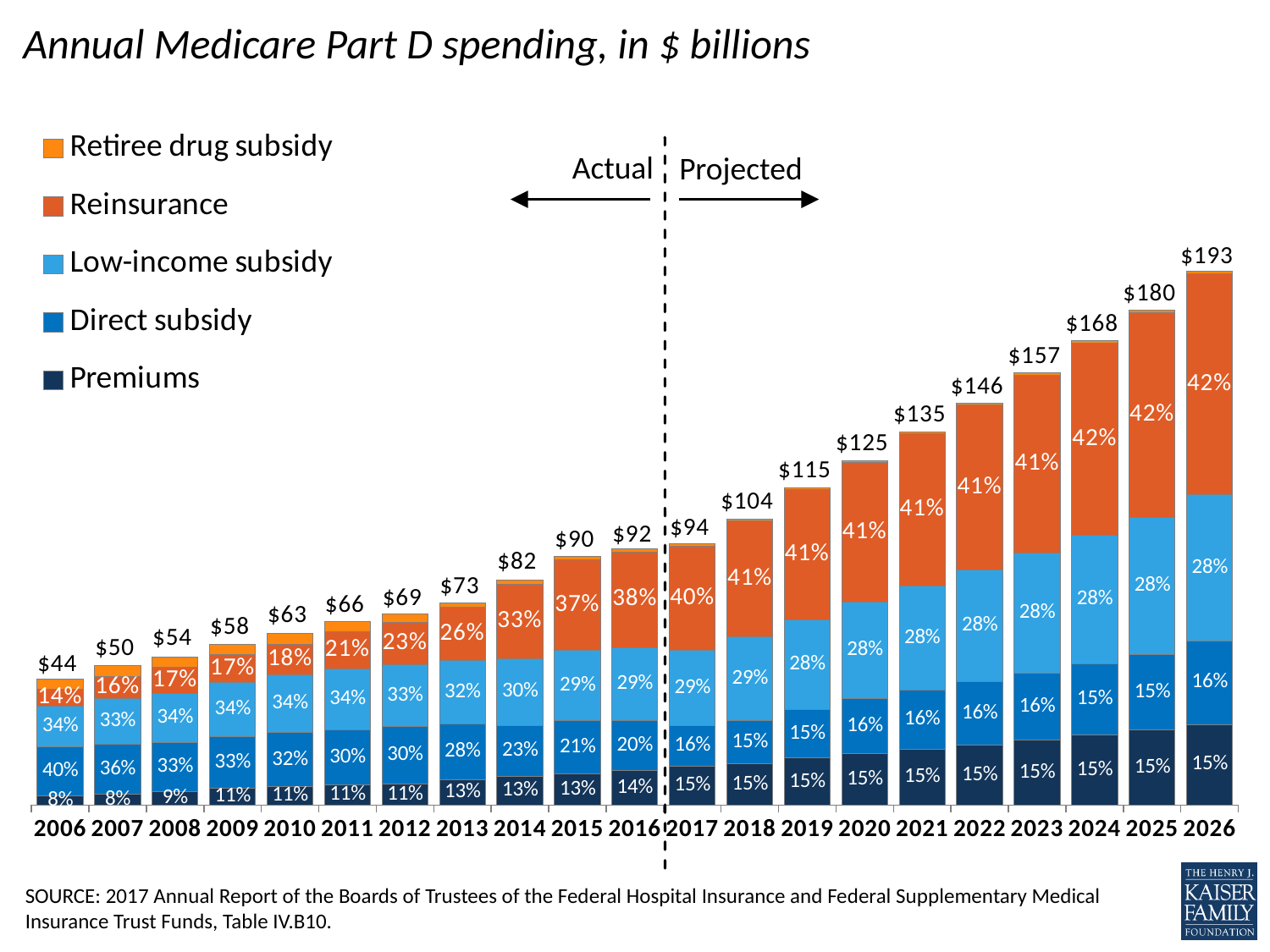
Which year has the lowest total spending? 2006 How many years are shown on the x axis? 21 What kind of chart is this? Stacked bar chart What is the total annual Medicare Part D spending shown for 2006? $44 Do the total spending values rise or fall from 2006 to 2026? Rise Which year has the highest total spending? 2026 What is the total annual Medicare Part D spending shown for 2026? $193 What percentage of 2026 spending is labeled as Reinsurance? 42% What percentage of 2006 spending is labeled as Direct subsidy? 40% What is the difference between the total spending in 2026 and in 2006? $149 How many series does the legend list? 5 Which year has higher total spending, 2014 or 2018? 2018